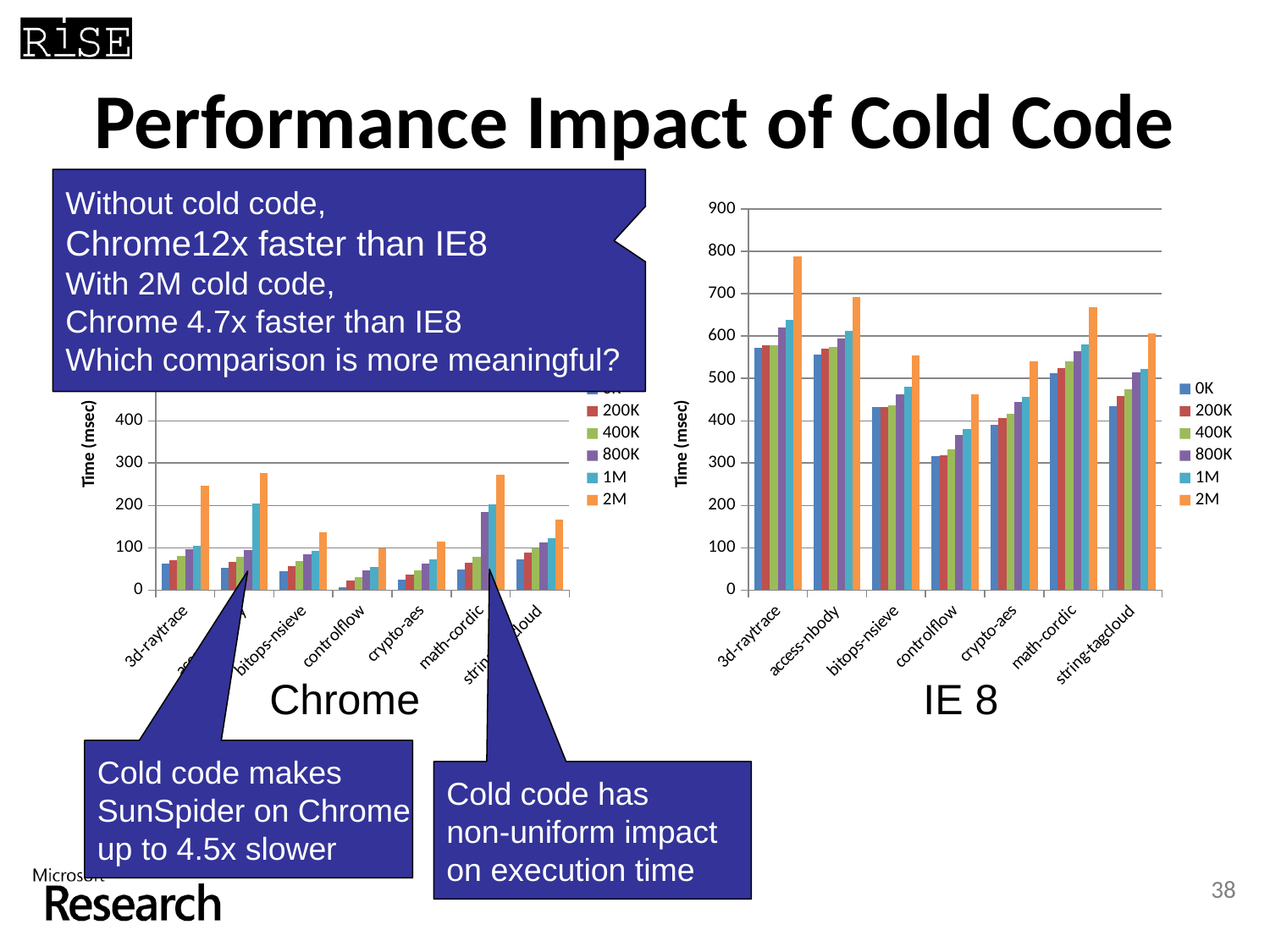
In the Chrome chart, is the 0K value for controlflow greater or less than 100? less In the IE 8 chart, which is larger: the 2M value for 3d-raytrace or the 2M value for bitops-nsieve? 3d-raytrace In the Chrome chart, is the 2M value for 3d-raytrace greater or less than 200? greater In the IE 8 chart, for 3d-raytrace, do the bars rise or fall going from 0K to 2M? rise In the IE 8 chart, is the 2M value for 3d-raytrace greater or less than 700? greater What kind of chart is the Chrome chart on the left? bar chart How many benchmark categories are shown on the x axis of the IE 8 chart? 7 How many series does the legend of the IE 8 chart list? 6 In the IE 8 chart, which category has the lowest 0K bar? controlflow In the IE 8 chart, which category has the highest 2M bar? 3d-raytrace What is the y-axis label of the IE 8 chart? Time (msec)